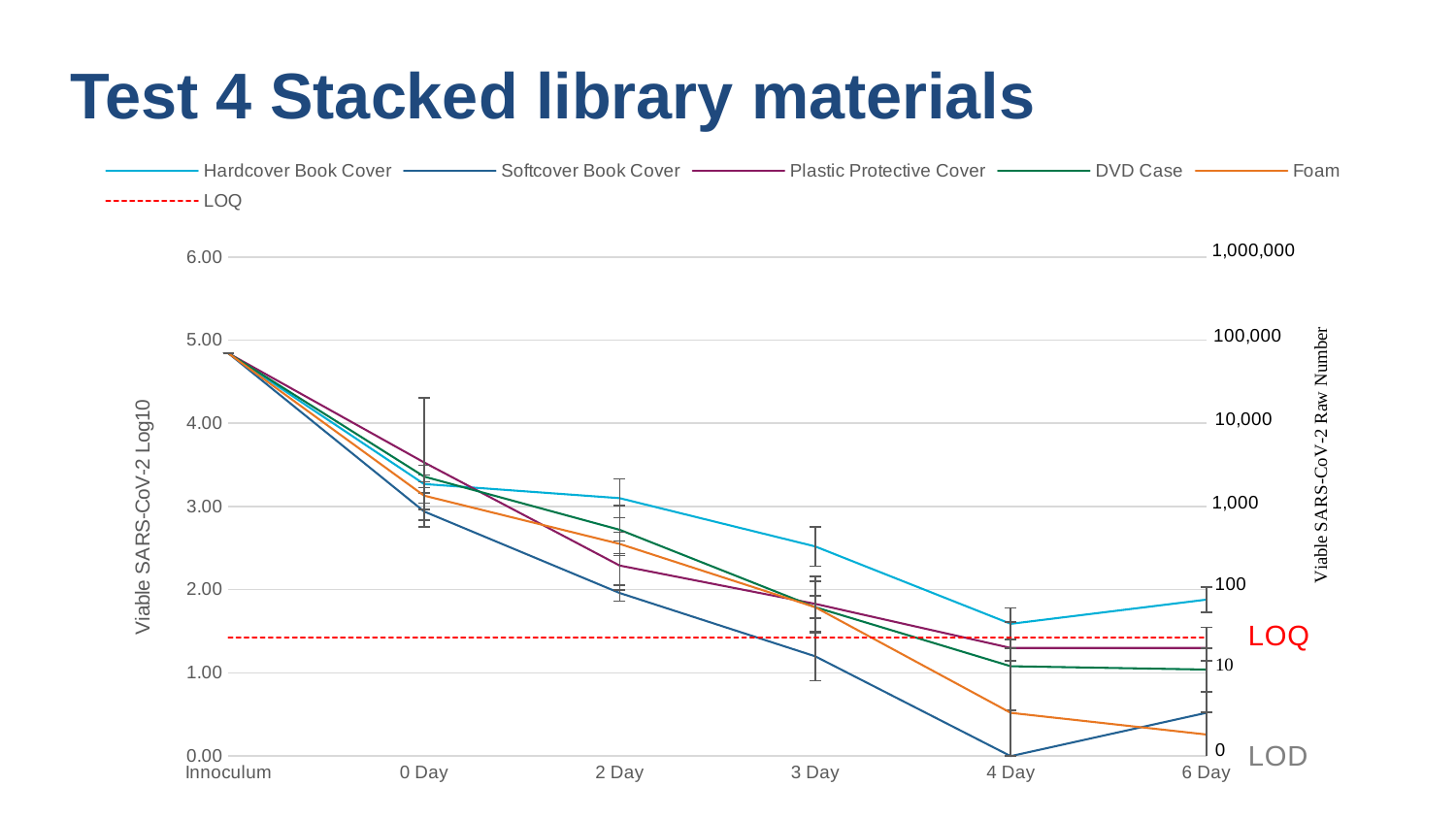
How many points are there along the x axis? 6 What is the title of the slide? Test 4 Stacked library materials Does the Softcover Book Cover series rise or fall from Innoculum to 4 Day? fall What kind of chart is shown on the slide? line chart Is the value for Hardcover Book Cover at 6 Day greater or less than 1.00? greater How many series does the legend list? 6 What is the label on the left y axis? Viable SARS-CoV-2 Log10 At 4 Day, which is larger: Hardcover Book Cover or Softcover Book Cover? Hardcover Book Cover Is the value for Foam at 6 Day greater or less than 1.00? less Which series has the highest value at 6 Day? Hardcover Book Cover Which series has the lowest value at 4 Day? Softcover Book Cover Is the value for Softcover Book Cover at 3 Day greater or less than 2.00? less